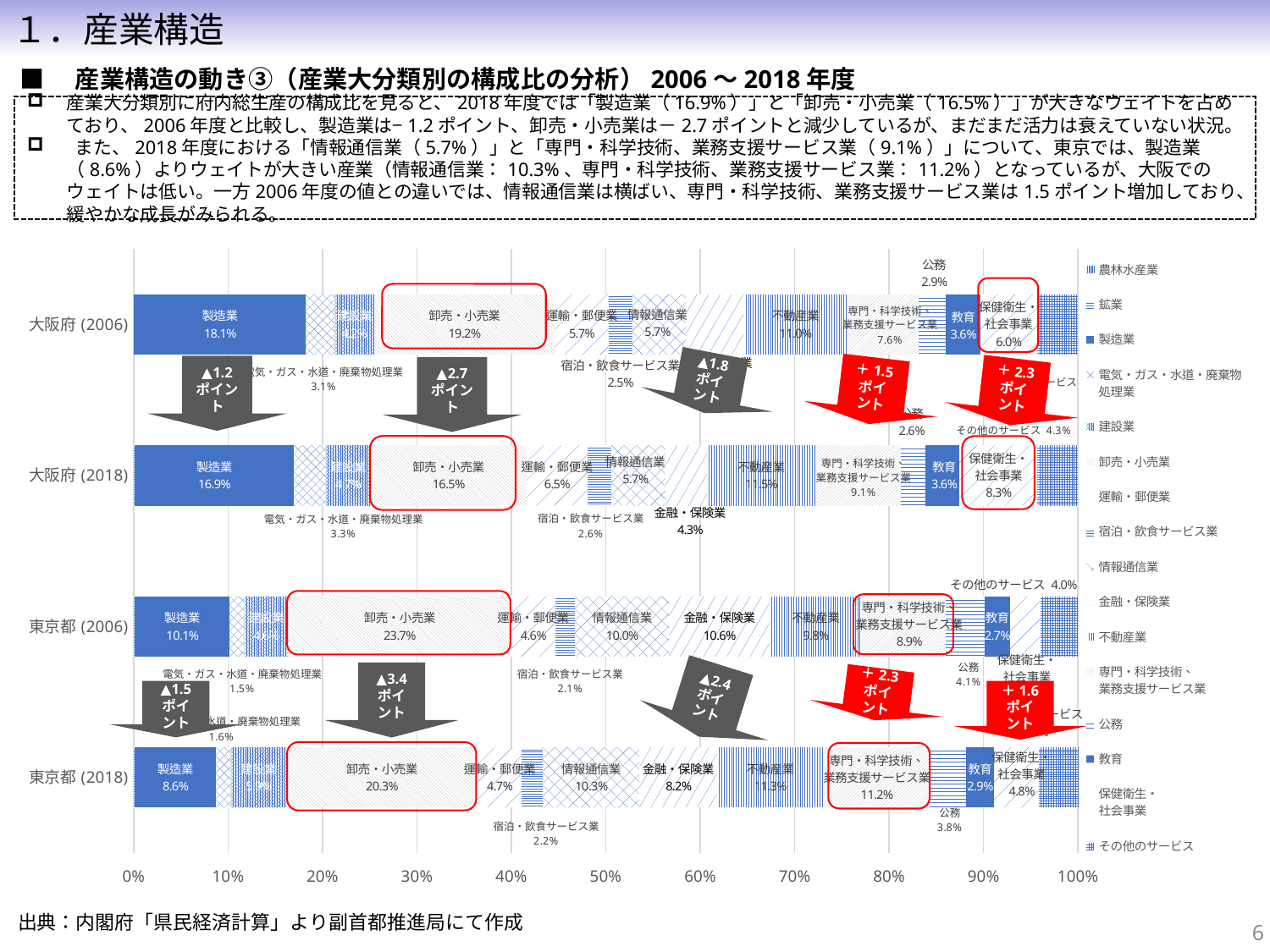
By how many percentage points did the 卸売・小売業 share for 大阪府 fall from 2006 (19.2%) to 2018 (16.5%)? 2.7 What is the share of 製造業 for 大阪府 (2018)? 16.9% What is the share of 情報通信業 for 東京都 (2018)? 10.3% Which is larger: the 金融・保険業 share for 東京都 (2006) or for 東京都 (2018)? 東京都 (2006) What is the first entry listed in the chart legend? 農林水産業 What is the difference between the 不動産業 share for 大阪府 (2018) (11.5%) and 大阪府 (2006) (11.0%)? 0.5 What kind of chart is shown on the slide? Stacked bar chart What is the share of 専門・科学技術、業務支援サービス業 for 大阪府 (2018)? 9.1% Which is larger: the 製造業 share for 大阪府 (2018) or for 東京都 (2018)? 大阪府 (2018) What is the share of 卸売・小売業 for 東京都 (2006)? 23.7% How many bars (region-year categories) does the chart show? 4 How many industry series does the legend list? 16